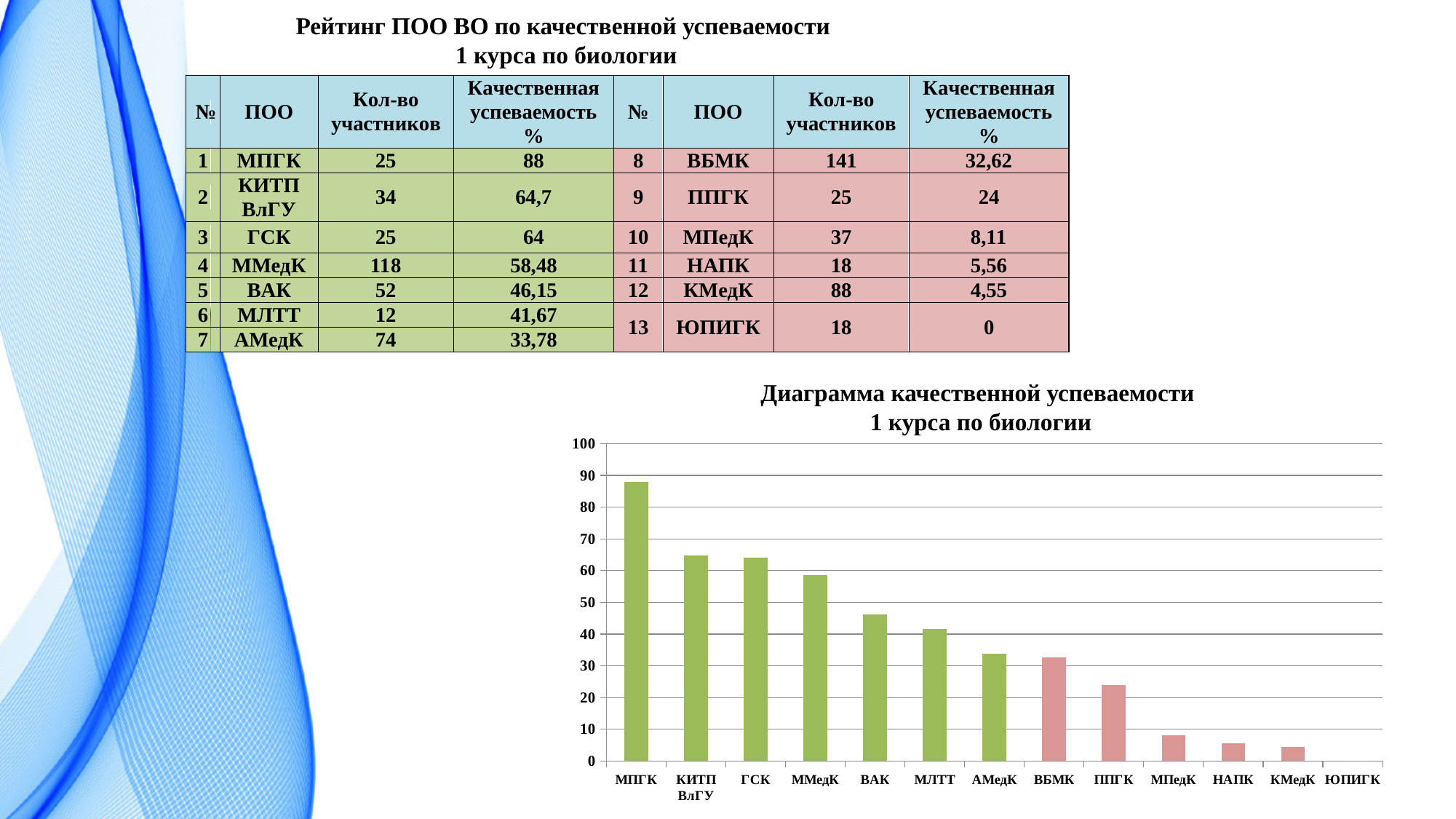
Is the value for МПГК greater or less than 80? greater Do the bar values rise or fall from left to right along the x axis? fall What kind of chart is shown on the slide? bar chart Which has the larger value, ВАК or МЛТТ? ВАК Is the value for ВБМК greater or less than 40? less What is the качественная успеваемость value for ГСК? 64 Which institution has the highest bar in the chart? МПГК Is the value for ППГК greater or less than 30? less What is the качественная успеваемость value for ММедК? 58,48 How many institutions (categories) are shown on the x axis of the chart? 13 What is the difference between the values for МПГК and ГСК? 24 Which institution has the lowest value in the chart? ЮПИГК